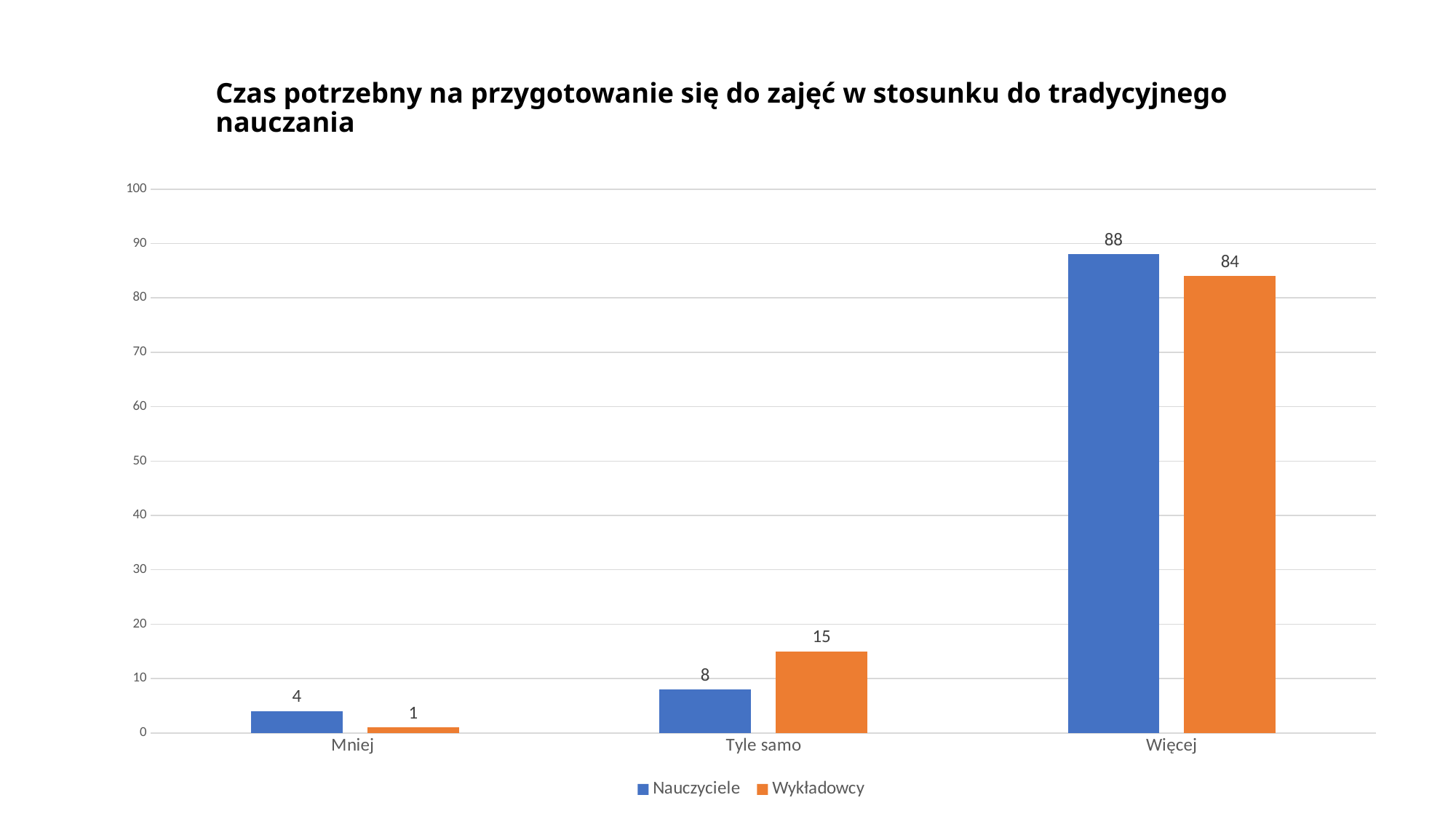
Which category has the highest value for Nauczyciele? Więcej What kind of chart is shown on the slide? Bar chart How many categories are shown on the x axis? 3 What is the value for Nauczyciele in the Więcej category? 88 Which category has the lowest value for Wykładowcy? Mniej What is the difference between Wykładowcy and Nauczyciele in the Tyle samo category? 7 How many series does the legend list? 2 Which colour represents the Wykładowcy series? Orange What is the value for Wykładowcy in the Mniej category? 1 What is the value for Wykładowcy in the Tyle samo category? 15 In the Tyle samo category, which series has the larger value, Nauczyciele or Wykładowcy? Wykładowcy What is the difference between Nauczyciele and Wykładowcy in the Więcej category? 4